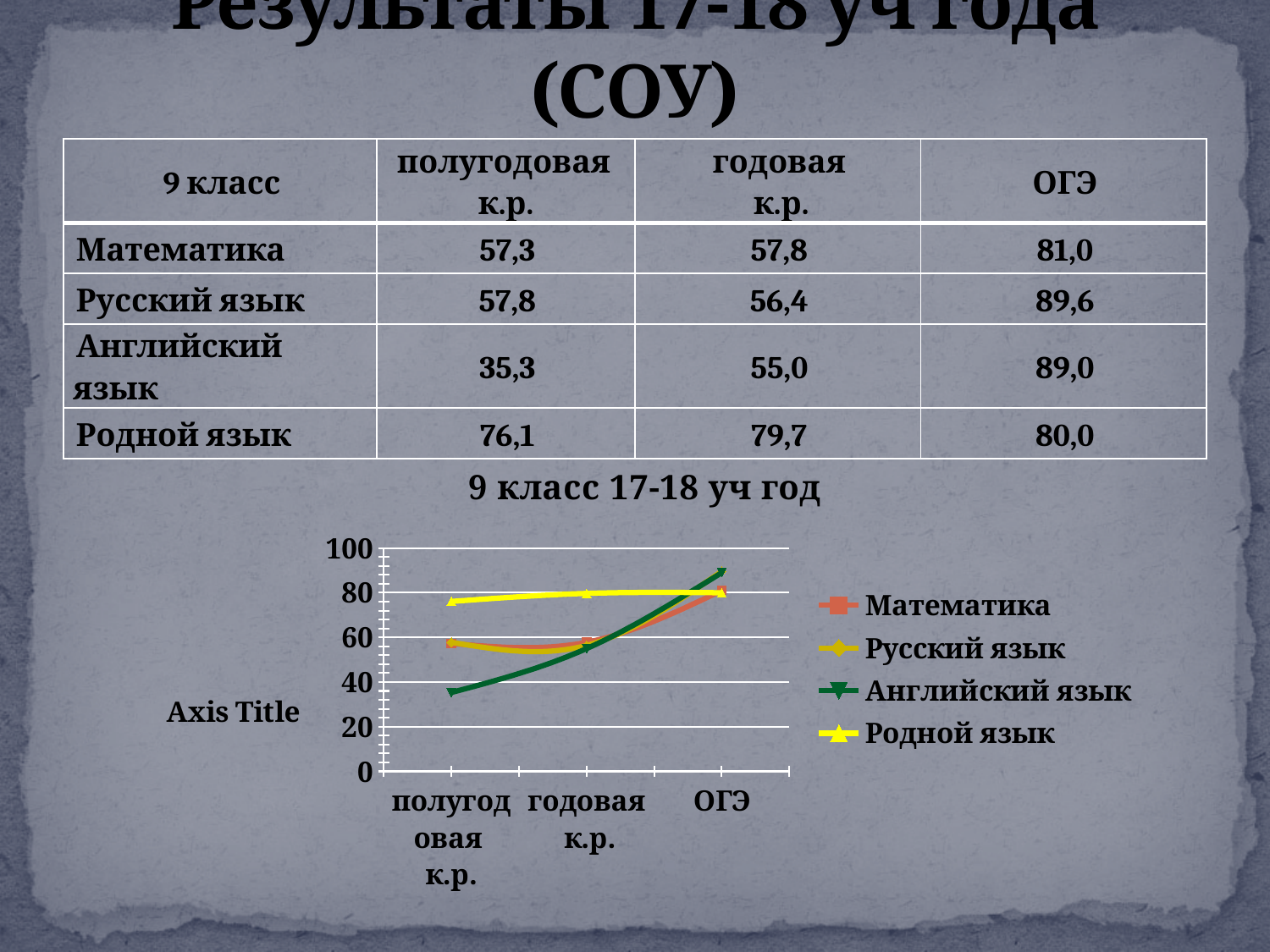
What is the title of the chart? 9 класс 17-18 уч год How many categories are on the x axis of the chart? 3 Which series is highest at полугодовая к.р.? Родной язык What kind of chart is shown on the slide? line chart Is the value for Английский язык at полугодовая к.р. greater or less than 40? less Is the value for Родной язык at полугодовая к.р. greater or less than 60? greater How many series does the chart legend list? 4 Does the Английский язык line rise or fall from полугодовая к.р. to ОГЭ? rises What is the value for Английский язык at полугодовая к.р., as given in the table? 35,3 Is the value for Английский язык at ОГЭ greater or less than 80? greater Which series is lowest at полугодовая к.р.? Английский язык At полугодовая к.р., which is larger: Родной язык or Математика? Родной язык